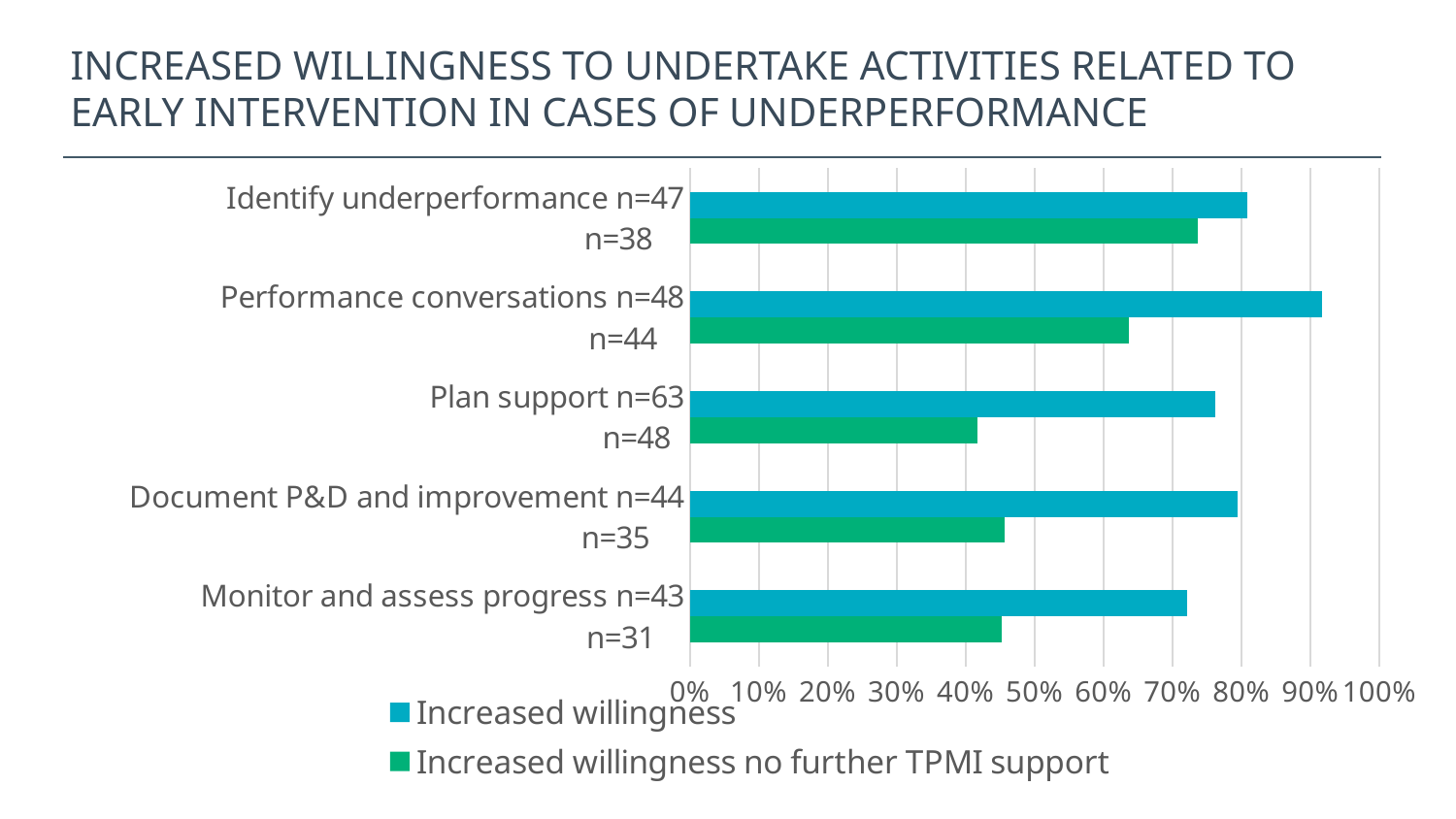
Is the Increased willingness no further TPMI support value for Identify underperformance greater or less than 70%? greater Is the Increased willingness no further TPMI support value for Plan support greater or less than 50%? less For Document P&D and improvement, which series has the larger value: Increased willingness or Increased willingness no further TPMI support? Increased willingness For Plan support, which series has the larger value: Increased willingness or Increased willingness no further TPMI support? Increased willingness Is the Increased willingness value for Monitor and assess progress greater or less than 60%? greater What kind of chart is shown on the slide? Bar chart Which activity has the highest value for the Increased willingness series? Performance conversations How many activity categories are plotted on the chart? 5 Which activity has the highest value for the Increased willingness no further TPMI support series? Identify underperformance How many series does the legend list? 2 What is the sample size (n) shown for the Increased willingness series for Plan support? n=63